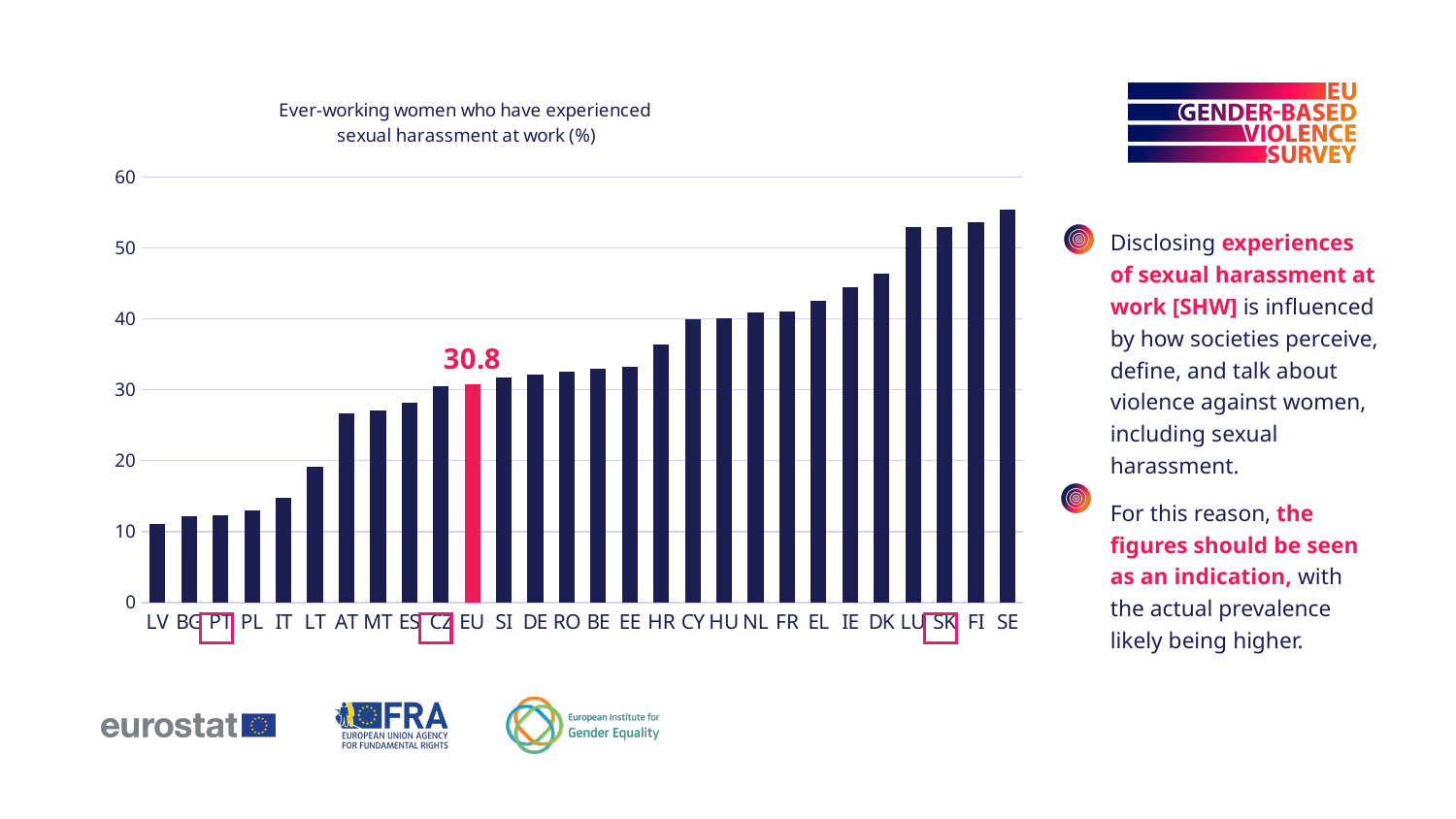
Which category has the highest value? SE Which has a larger value, DE or IE? IE How many categories are shown on the x axis? 28 Is the value for SE greater or less than 50? greater Is the value for LV greater or less than 20? less What kind of chart is shown on the slide? Bar chart Which has a larger value, FI or PT? FI Do the values rise or fall from left to right along the x axis? Rise Is the value for DK greater or less than 50? less Which category has the lowest value? LV What is the value shown for EU? 30.8